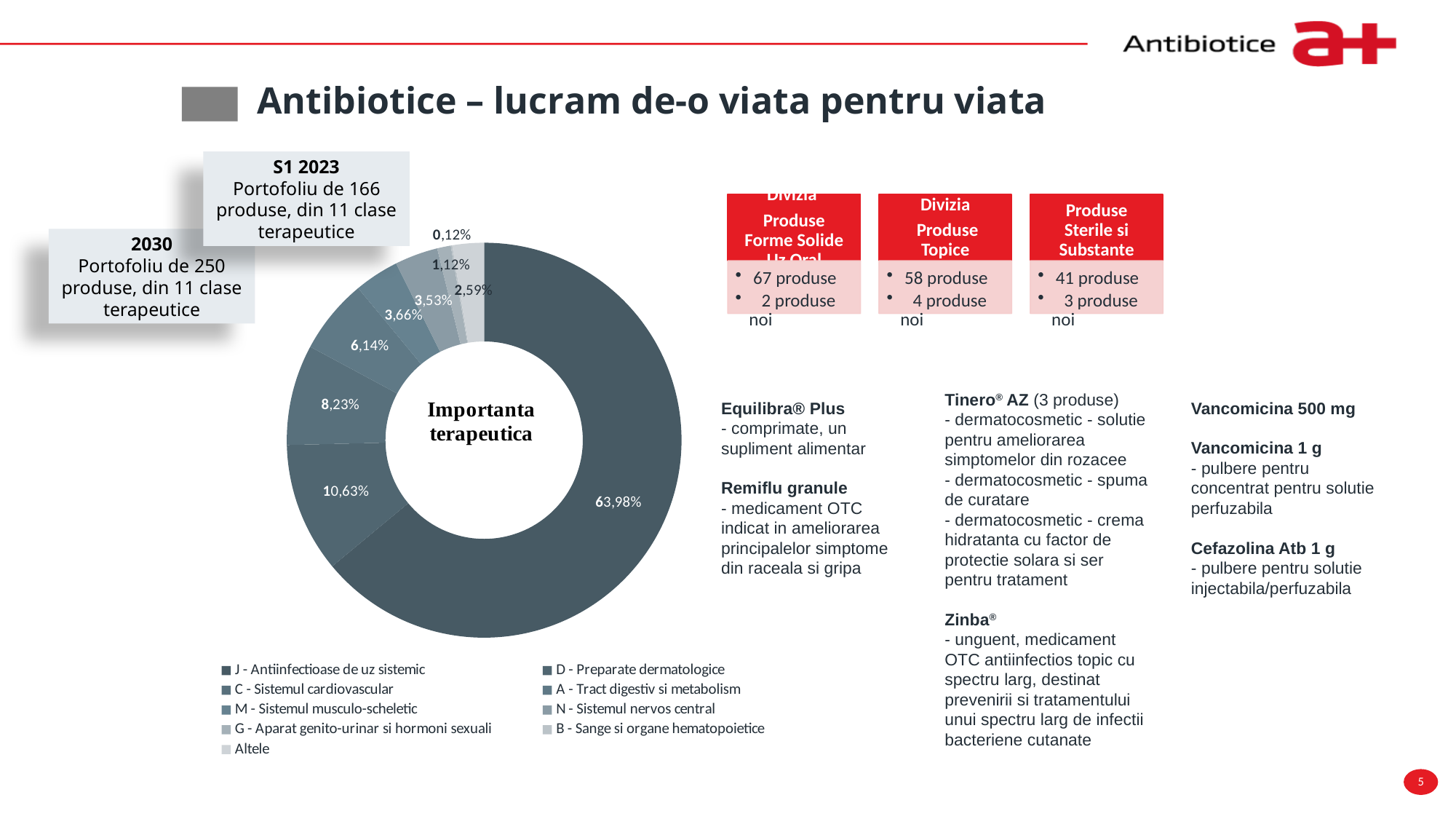
What kind of chart is shown on the slide? doughnut (pie) chart Which is larger, the slice labelled 8,23% or the slice labelled 6,14%? 8,23% What is the smallest percentage shown on the doughnut chart? 0,12% What is the value of the slice for D - Preparate dermatologice? 10,63% Is the largest slice of the doughnut chart greater or less than 50%? greater What is the combined share of the two smallest slices, 1,12% and 0,12%? 1,24% What is the value of the slice for J - Antiinfectioase de uz sistemic? 63,98% Which category has the largest slice in the doughnut chart? J - Antiinfectioase de uz sistemic What percentage is shown for the largest slice of the doughnut chart? 63,98% How many categories does the legend of the doughnut chart list? 9 What is the difference between the largest slice (63,98%) and the second largest slice (10,63%)? 53,35% What is the title shown in the centre of the doughnut chart? Importanta terapeutica